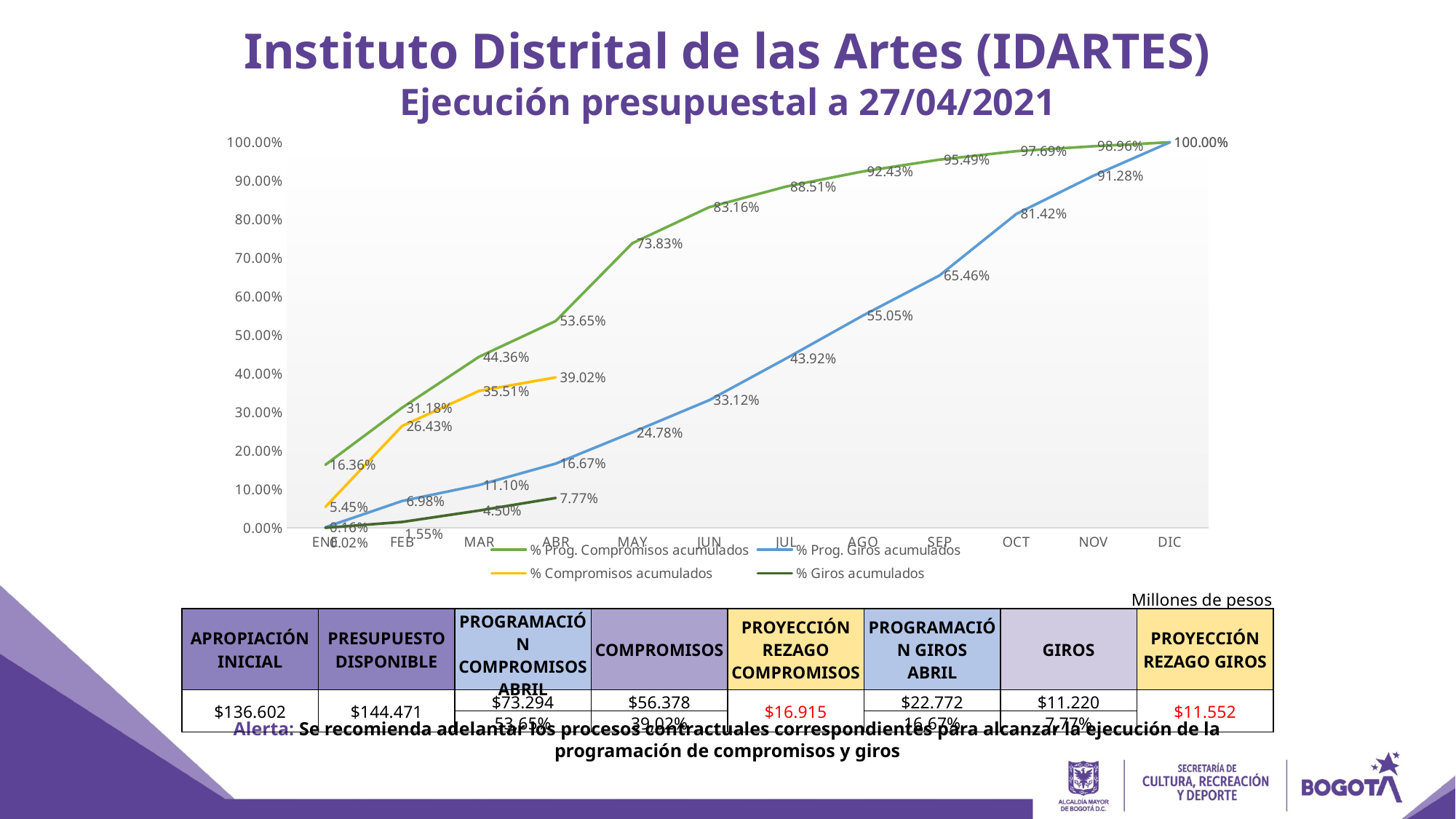
How many series does the chart legend list? 4 Which is larger in MAR: % Prog. Compromisos acumulados or % Compromisos acumulados? % Prog. Compromisos acumulados How many months are shown on the x axis of the chart? 12 What type of chart is shown on the slide? line chart What is the value of % Prog. Compromisos acumulados for MAY? 73.83% What is the value of % Compromisos acumulados for ABR? 39.02% In which month does % Prog. Compromisos acumulados reach its highest value? DIC What is the value of % Giros acumulados for ABR? 7.77% What is the difference between % Prog. Compromisos acumulados and % Compromisos acumulados in ABR? 14.63% What is the value of % Prog. Giros acumulados for OCT? 81.42% Does the % Prog. Giros acumulados series rise or fall from ENE to DIC? rise What is the difference between % Prog. Giros acumulados and % Giros acumulados in ABR? 8.90%